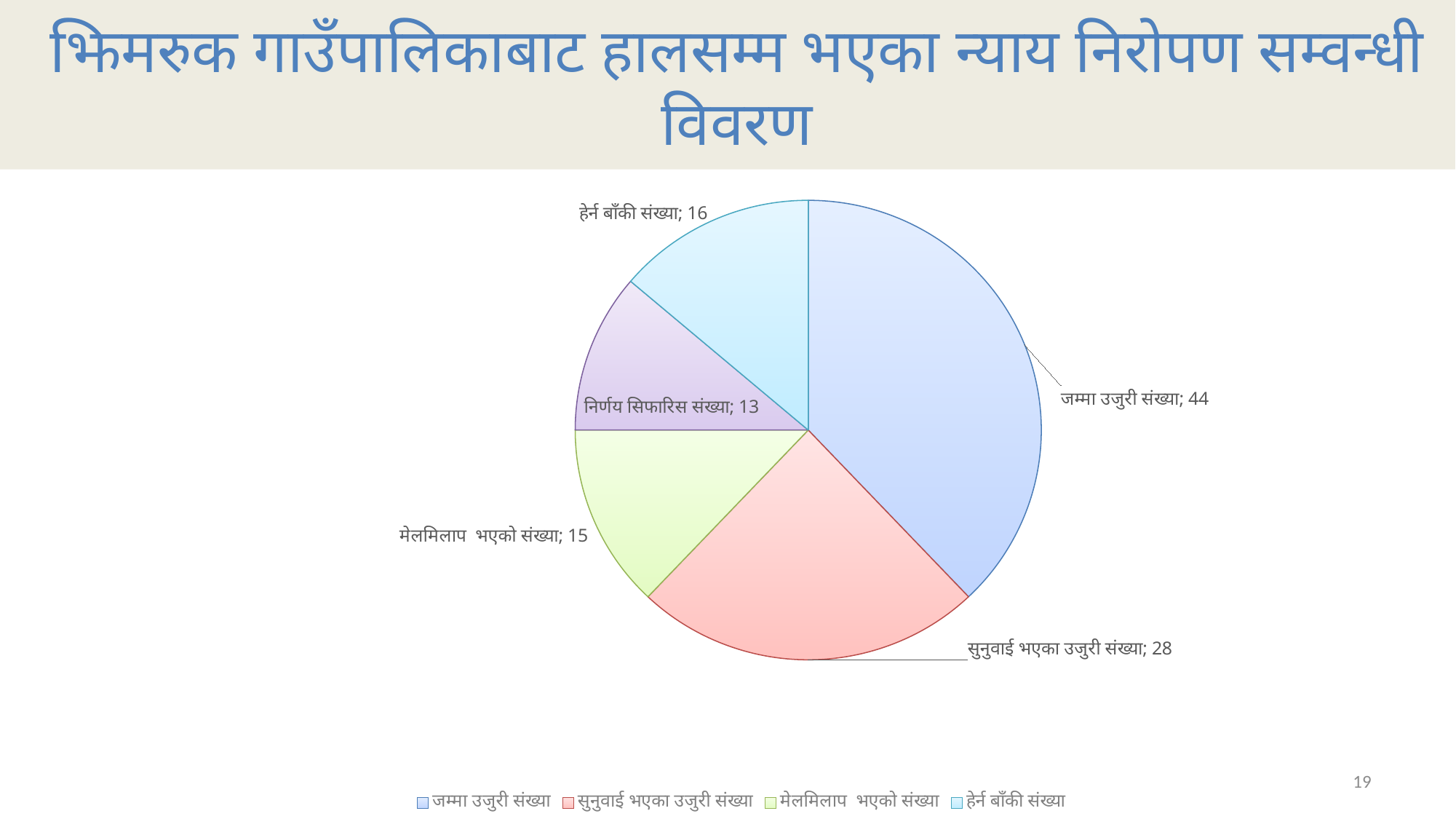
Which is larger, हेर्न बाँकी संख्या or मेलमिलाप भएको संख्या? हेर्न बाँकी संख्या Which slice of the pie is the smallest? निर्णय सिफारिस संख्या What is the value for जम्मा उजुरी संख्या? 44 What is the value for मेलमिलाप भएको संख्या? 15 How many slices does the pie chart have? 5 What kind of chart is shown on the slide? pie chart What is the difference between जम्मा उजुरी संख्या and सुनुवाई भएका उजुरी संख्या? 16 What is the value for सुनुवाई भएका उजुरी संख्या? 28 What is the value for निर्णय सिफारिस संख्या? 13 Which slice of the pie is the largest? जम्मा उजुरी संख्या How many entries does the legend list? 4 What is the value for हेर्न बाँकी संख्या? 16